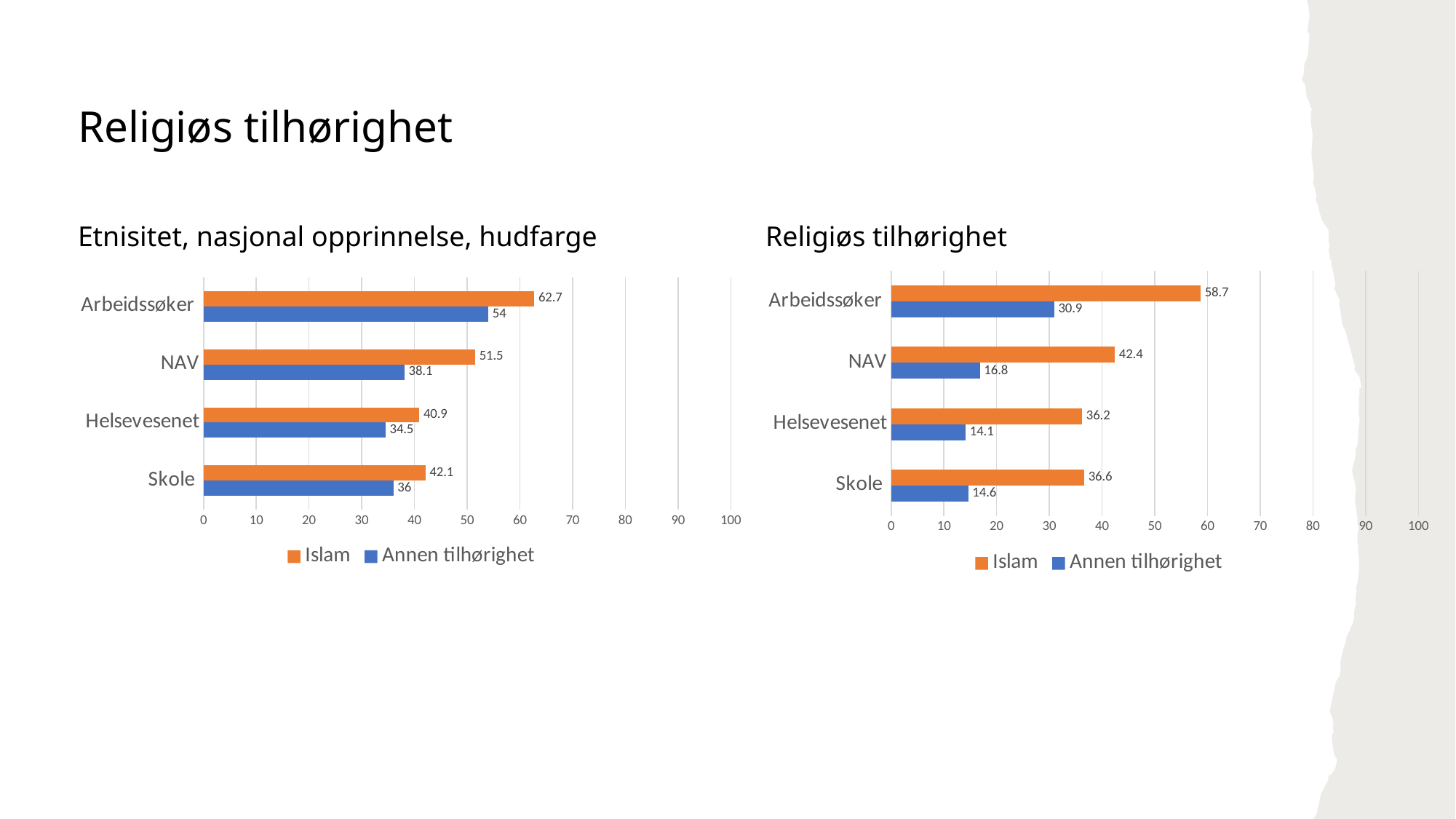
What kind of chart is the chart titled 'Etnisitet, nasjonal opprinnelse, hudfarge'? Bar chart In the chart titled 'Etnisitet, nasjonal opprinnelse, hudfarge', which is larger for NAV: Islam or Annen tilhørighet? Islam How many categories are shown in the chart titled 'Etnisitet, nasjonal opprinnelse, hudfarge'? 4 How many series does the legend list in the chart titled 'Religiøs tilhørighet'? 2 In the chart titled 'Religiøs tilhørighet', is the Islam value for Skole greater or less than 30? greater In the chart titled 'Religiøs tilhørighet', which category has the highest Islam value? Arbeidssøker In the chart titled 'Religiøs tilhørighet', what is the difference between the Islam values for Arbeidssøker and NAV? 16.3 In the chart titled 'Religiøs tilhørighet', what is the value for Annen tilhørighet for NAV? 16.8 In the chart titled 'Etnisitet, nasjonal opprinnelse, hudfarge', which colour represents Islam? Orange In the chart titled 'Etnisitet, nasjonal opprinnelse, hudfarge', which category has the lowest Annen tilhørighet value? Helsevesenet In the chart titled 'Etnisitet, nasjonal opprinnelse, hudfarge', what is the value for Islam for Arbeidssøker? 62.7 In the chart titled 'Religiøs tilhørighet', what is the difference between the Islam and Annen tilhørighet values for Arbeidssøker? 27.8